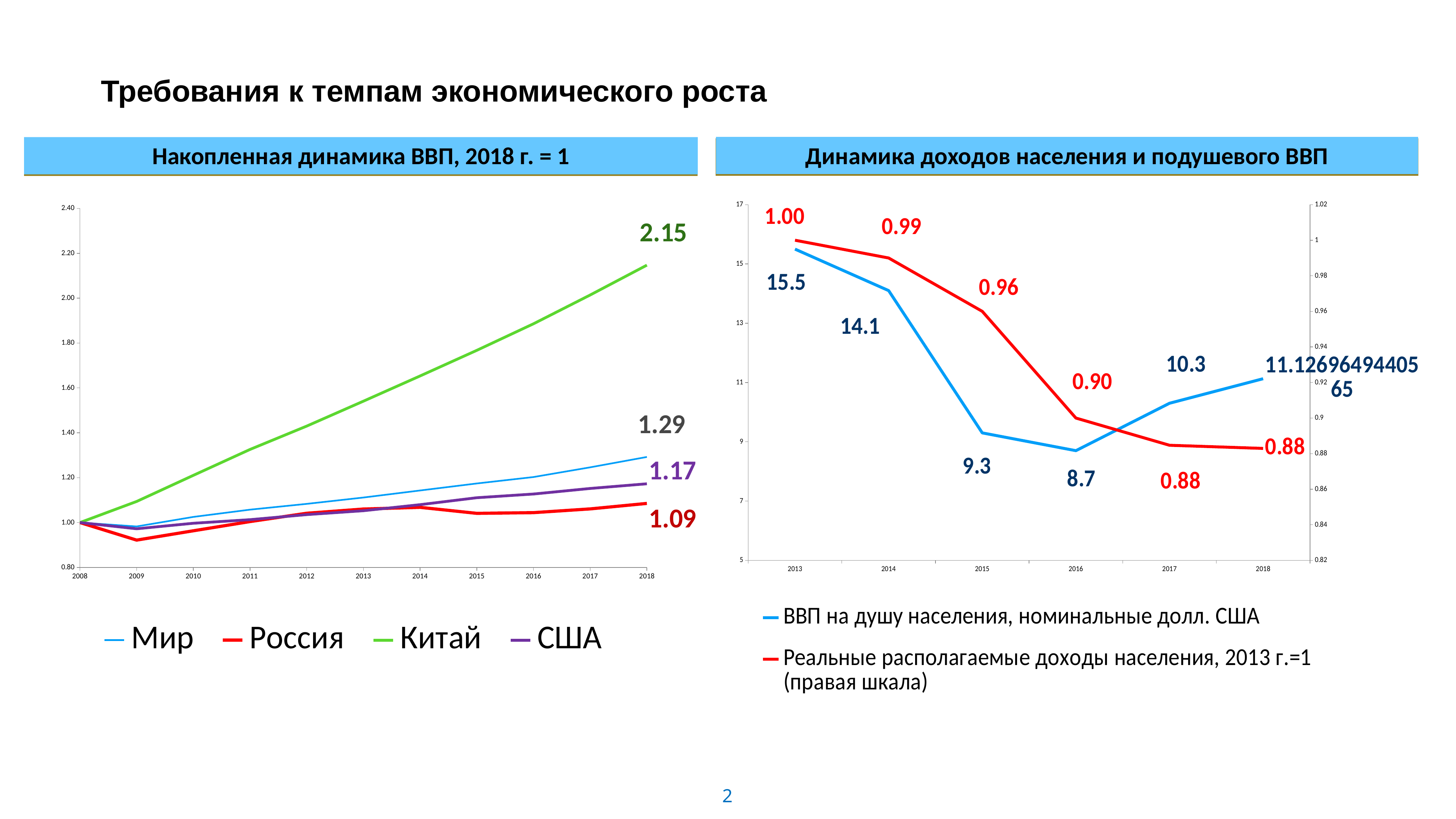
On the chart 'Накопленная динамика ВВП, 2018 г. = 1', which series has the lowest value in 2018? Россия On the chart 'Накопленная динамика ВВП, 2018 г. = 1', what is the value for Китай in 2018? 2.15 On the chart 'Накопленная динамика ВВП, 2018 г. = 1', what is the difference between the 2018 values for Мир and США? 0.12 On the chart 'Динамика доходов населения и подушевого ВВП', what is the value of ВВП на душу населения in 2014? 14.1 On the chart 'Накопленная динамика ВВП, 2018 г. = 1', which series has the highest value in 2018? Китай On the chart 'Накопленная динамика ВВП, 2018 г. = 1', what is the value for Россия in 2018? 1.09 On the chart 'Динамика доходов населения и подушевого ВВП', what is the value of Реальные располагаемые доходы населения in 2016? 0.90 On the chart 'Динамика доходов населения и подушевого ВВП', how many years are shown on the x axis? 6 On the chart 'Динамика доходов населения и подушевого ВВП', what is the difference between ВВП на душу населения in 2013 and 2016? 6.8 On the chart 'Накопленная динамика ВВП, 2018 г. = 1', what kind of chart is it? Line chart On the chart 'Динамика доходов населения и подушевого ВВП', in which year is ВВП на душу населения lowest? 2016 On the chart 'Накопленная динамика ВВП, 2018 г. = 1', how many series does the legend list? 4